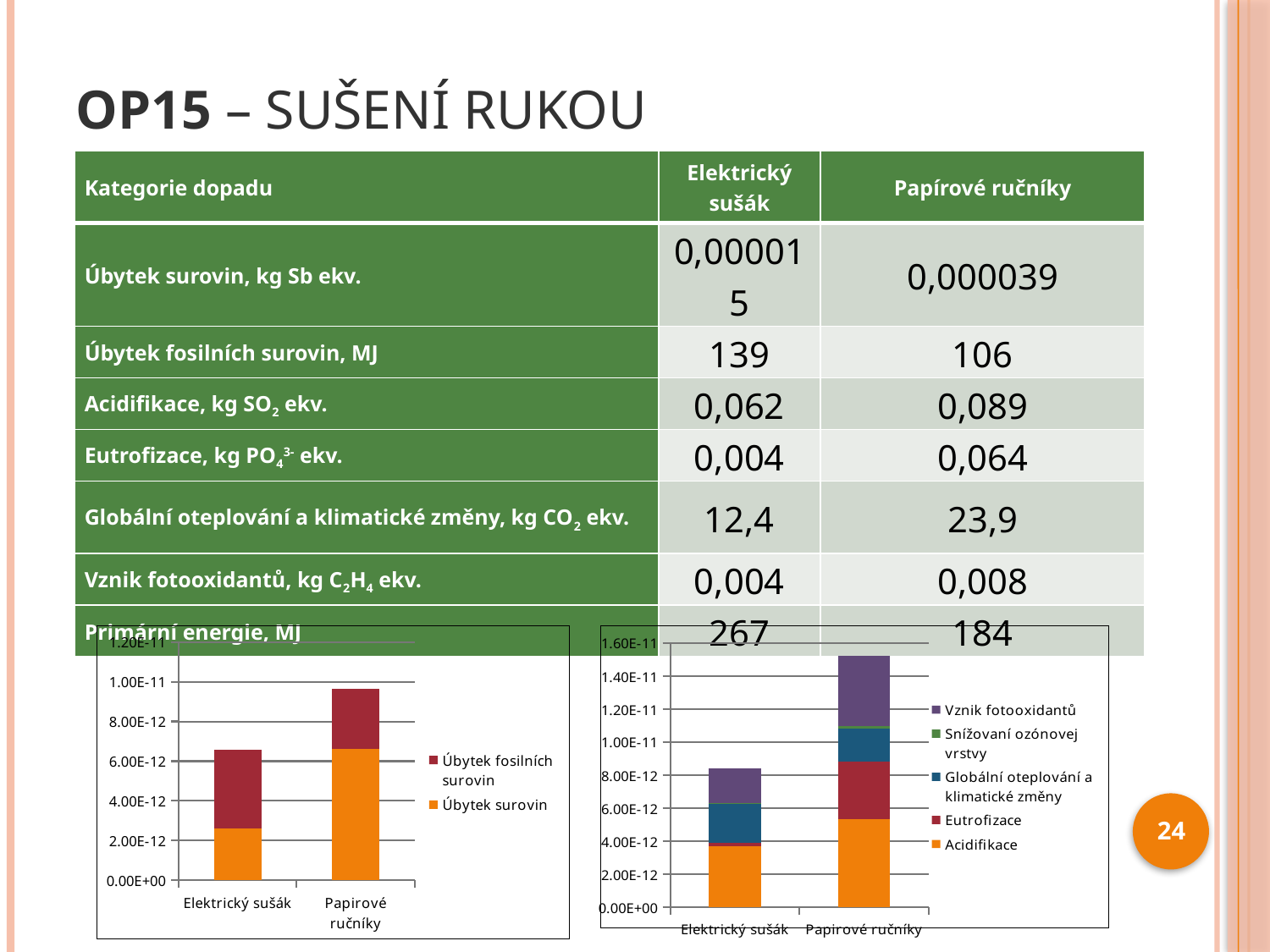
In the right chart, is the total stacked value for Papírové ručníky greater or less than 1.40E-11? greater How many series does the legend of the right chart list? 5 In the right chart, which category has the shorter stacked bar? Elektrický sušák In the left chart, is the total stacked value for Papírové ručníky greater or less than 8.00E-12? greater In the right chart, which series is shown in purple according to the legend? Vznik fotooxidantů How many series does the legend of the left chart list? 2 In the right chart, is the total stacked value for Elektrický sušák greater or less than 1.00E-11? less What kind of chart is the chart on the left of the slide? stacked bar chart In the left chart, which series is shown in orange according to the legend? Úbytek surovin How many categories are shown on the x axis of the right chart? 2 In the left chart, which category has the taller stacked bar? Papírové ručníky